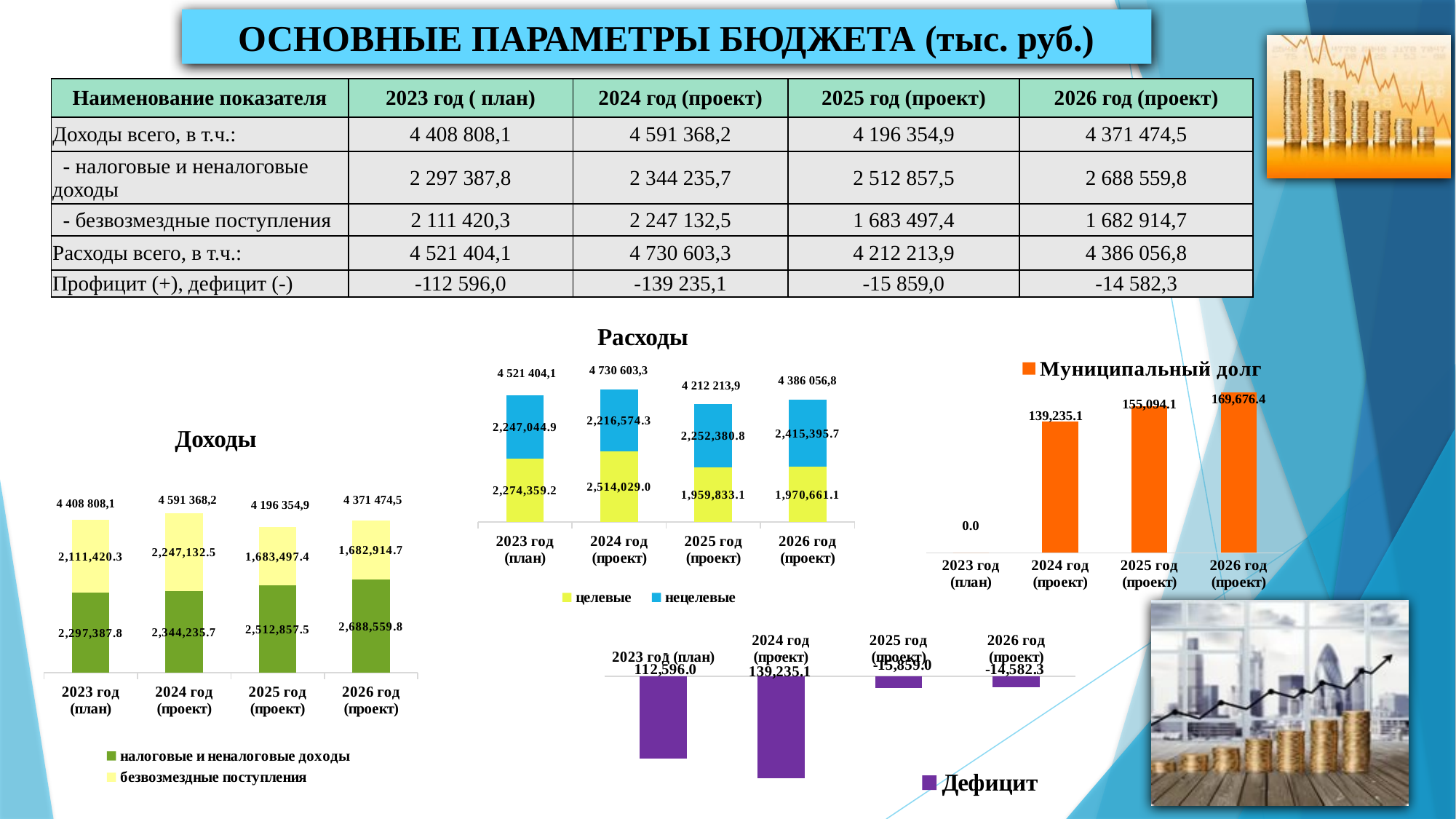
In the "Расходы" chart, what is the value of целевые for 2024 год (проект)? 2,514,029.0 In the "Доходы" chart, how many series does the legend list? 2 In the "Расходы" chart, which year has the highest total expenditure? 2024 год (проект) In the "Муниципальный долг" chart, what is the difference between the values for 2026 год (проект) and 2024 год (проект)? 30,441.3 In the "Муниципальный долг" chart, do the values rise or fall from 2023 to 2026? rise In the "Дефицит" chart, what is the value for 2025 год (проект)? -15,859.0 In the "Муниципальный долг" chart, what is the value for 2025 год (проект)? 155,094.1 In the "Расходы" chart, what is the value of нецелевые for 2026 год (проект)? 2,415,395.7 In the "Доходы" chart, what is the total shown above the bar for 2026 год (проект)? 4 371 474,5 In the "Доходы" chart, what is the value of безвозмездные поступления for 2025 год (проект)? 1,683,497.4 In the "Доходы" chart, what is the value of налоговые и неналоговые доходы for 2024 год (проект)? 2,344,235.7 What type of chart is the "Муниципальный долг" chart? bar chart